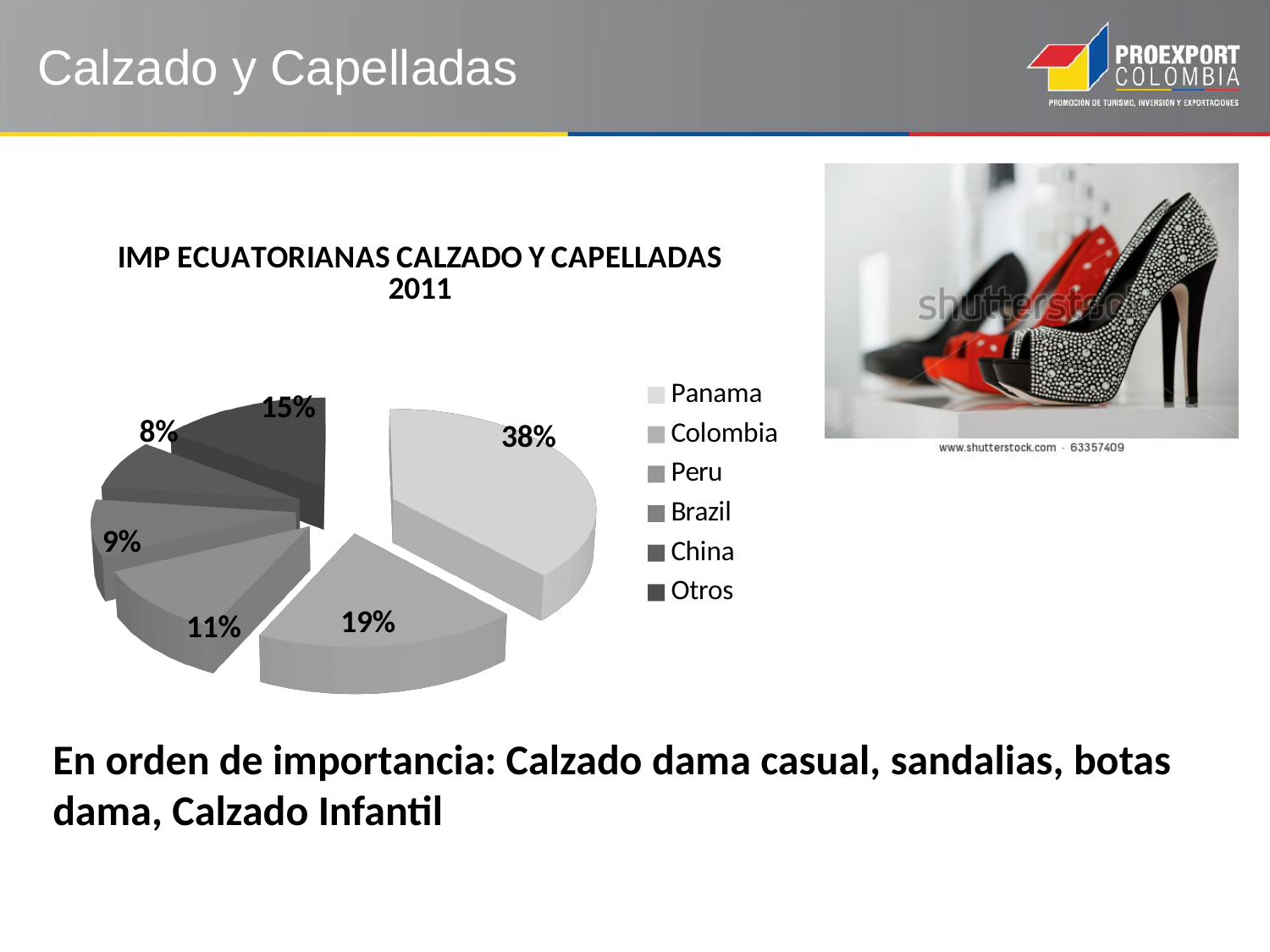
What is the difference in percentage points between Panama's share and Colombia's share? 19 What type of chart is shown on the slide? Pie chart Which category has the smallest slice of the pie? China Which has a larger share, Brazil or Otros? Otros What share of the pie does Panama hold? 38% What share of the pie does Colombia hold? 19% Which category has the largest slice of the pie? Panama What is the title of the chart? IMP ECUATORIANAS CALZADO Y CAPELLADAS 2011 Which legend entry is listed first in the chart's legend? Panama How many categories does the legend of the pie chart list? 6 What share of the pie does China hold? 8% What share of the pie does Peru hold? 11%